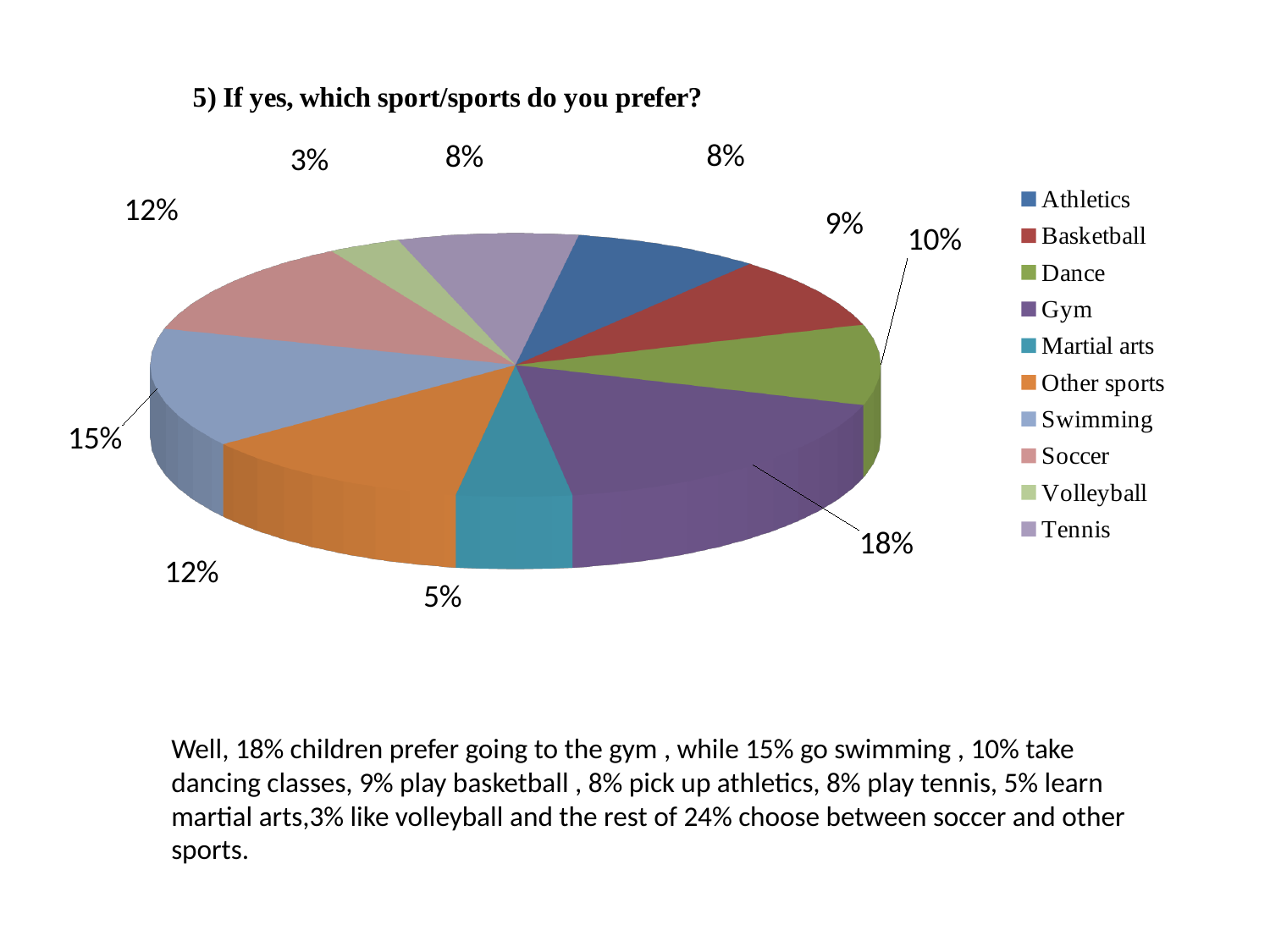
What is the title of the chart? 5) If yes, which sport/sports do you prefer? Which has a larger share, Basketball or Dance? Dance What kind of chart is shown on the slide? Pie chart What percentage of the pie chart is Dance? 10% How many categories does the pie chart show? 10 What is the difference in percentage points between Gym and Swimming? 3 What percentage of the pie chart is Martial arts? 5% Which sport has the smallest share of the pie chart? Volleyball What is the combined share of Soccer and Other sports? 24% What percentage of the pie chart is Swimming? 15% Which sport has the largest share of the pie chart? Gym What percentage of the pie chart is Gym? 18%